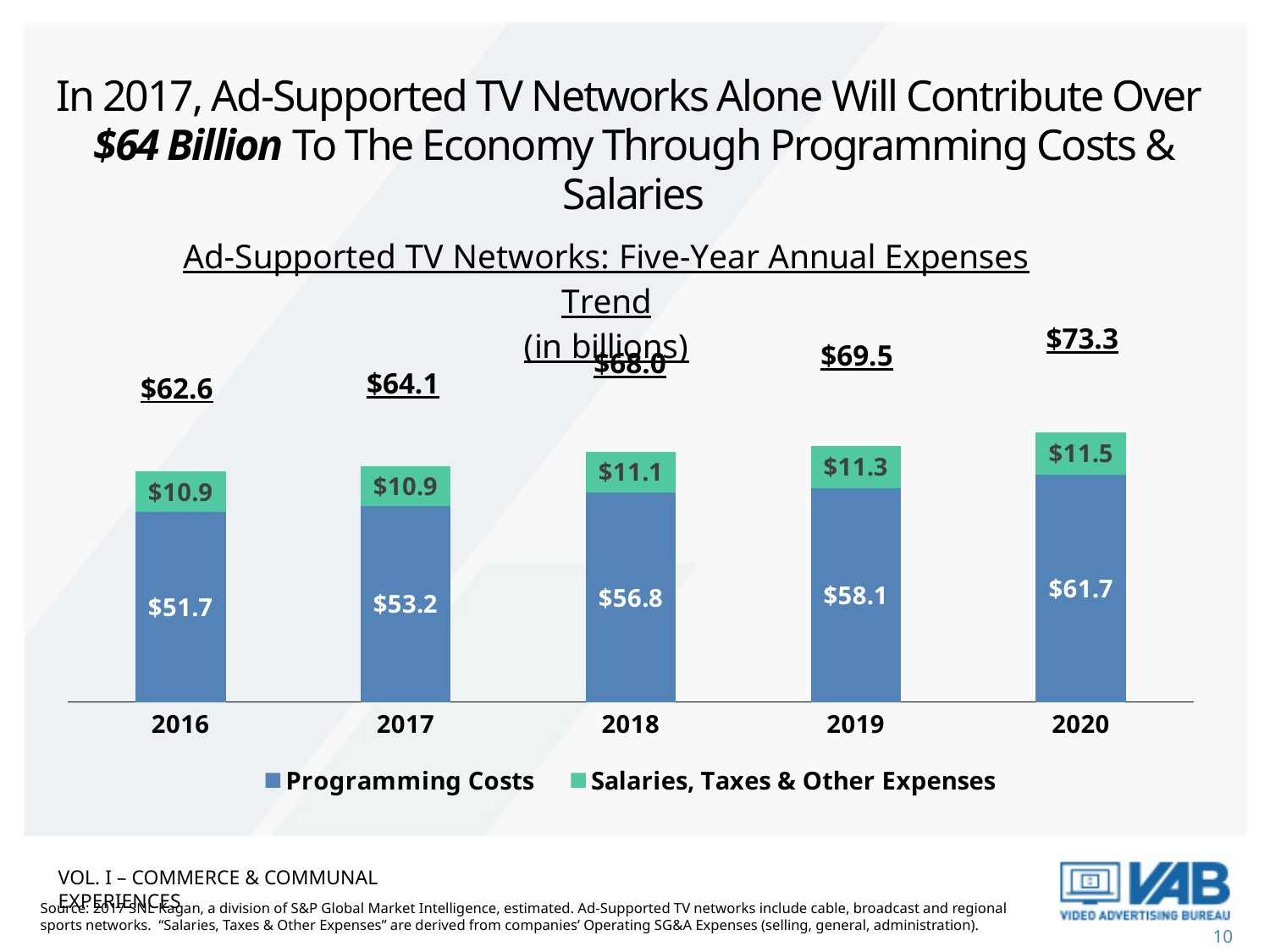
Which year has the highest Programming Costs? 2020 What is the difference in Programming Costs between 2020 and 2016? $10.0 What is the total of the stacked bar for 2019? $69.5 What is the value of Programming Costs for 2018? $56.8 Do total annual expenses rise or fall from 2016 to 2020? Rise What kind of chart is shown on the slide? Stacked bar chart How many series does the legend list? 2 How many years are shown on the x axis? 5 What is the value of Salaries, Taxes & Other Expenses for 2020? $11.5 What is the total annual expenses shown above the bar for 2017? $64.1 Which is larger: Salaries, Taxes & Other Expenses in 2019 or in 2018? 2019 Which year has the lowest total annual expenses? 2016